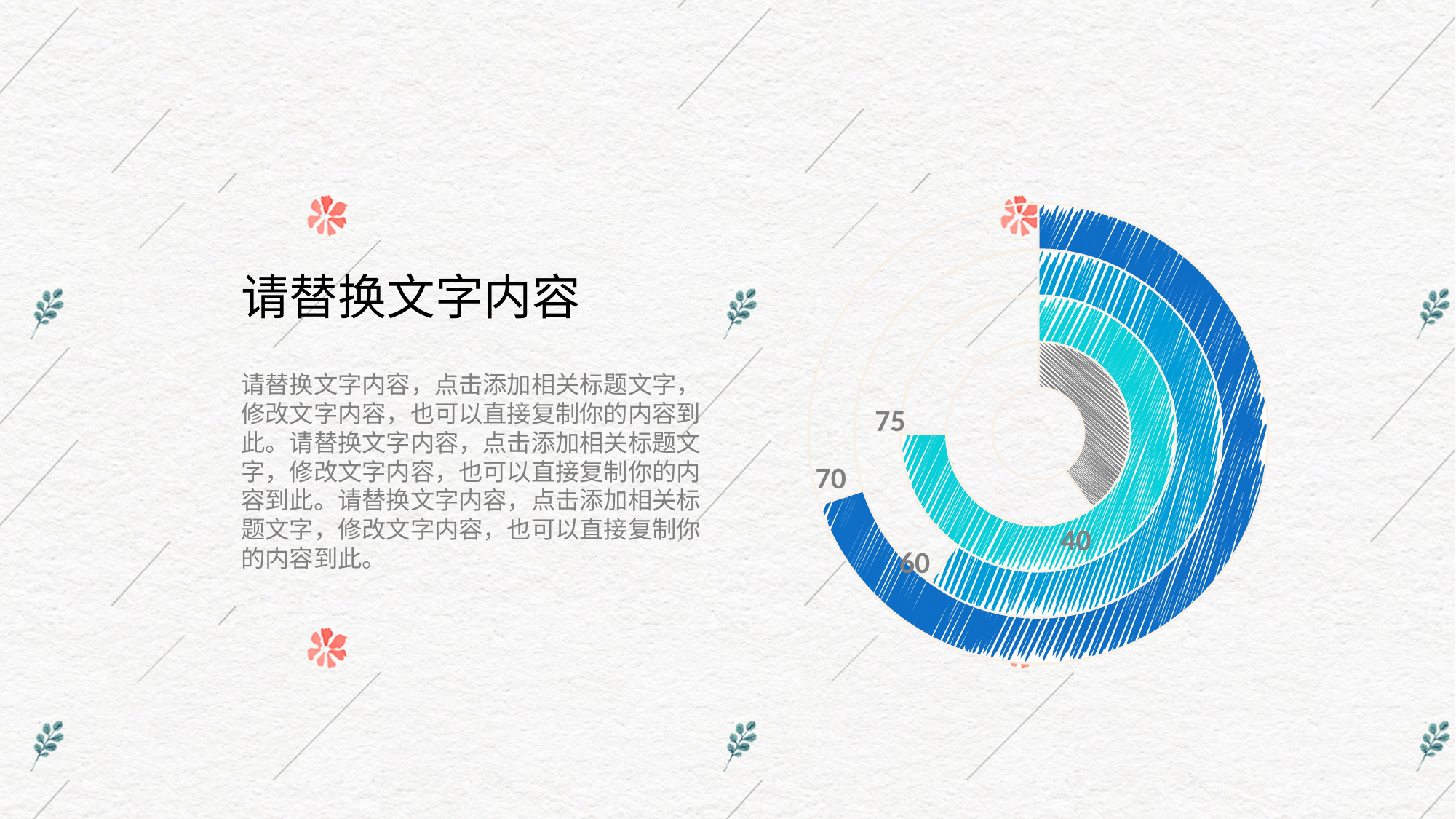
What value is labelled on the second ring from the outside? 60 What is the highest value labelled on the chart? 75 How many rings (data series) are plotted in the chart? 4 What kind of chart is shown on the slide? A doughnut (concentric ring) chart What is the difference between the highest labelled value (75) and the lowest labelled value (40)? 35 What colour is the innermost ring of the chart? Gray What is the lowest value labelled on the chart? 40 What value is labelled on the cyan ring (third from the outside)? 75 What is the difference between the values labelled 70 and 60? 10 Which is larger, the value on the outermost ring or the value on the second ring from the outside? The outermost ring (70) What value is labelled on the outermost ring of the chart? 70 What value is labelled on the innermost (gray) ring of the chart? 40